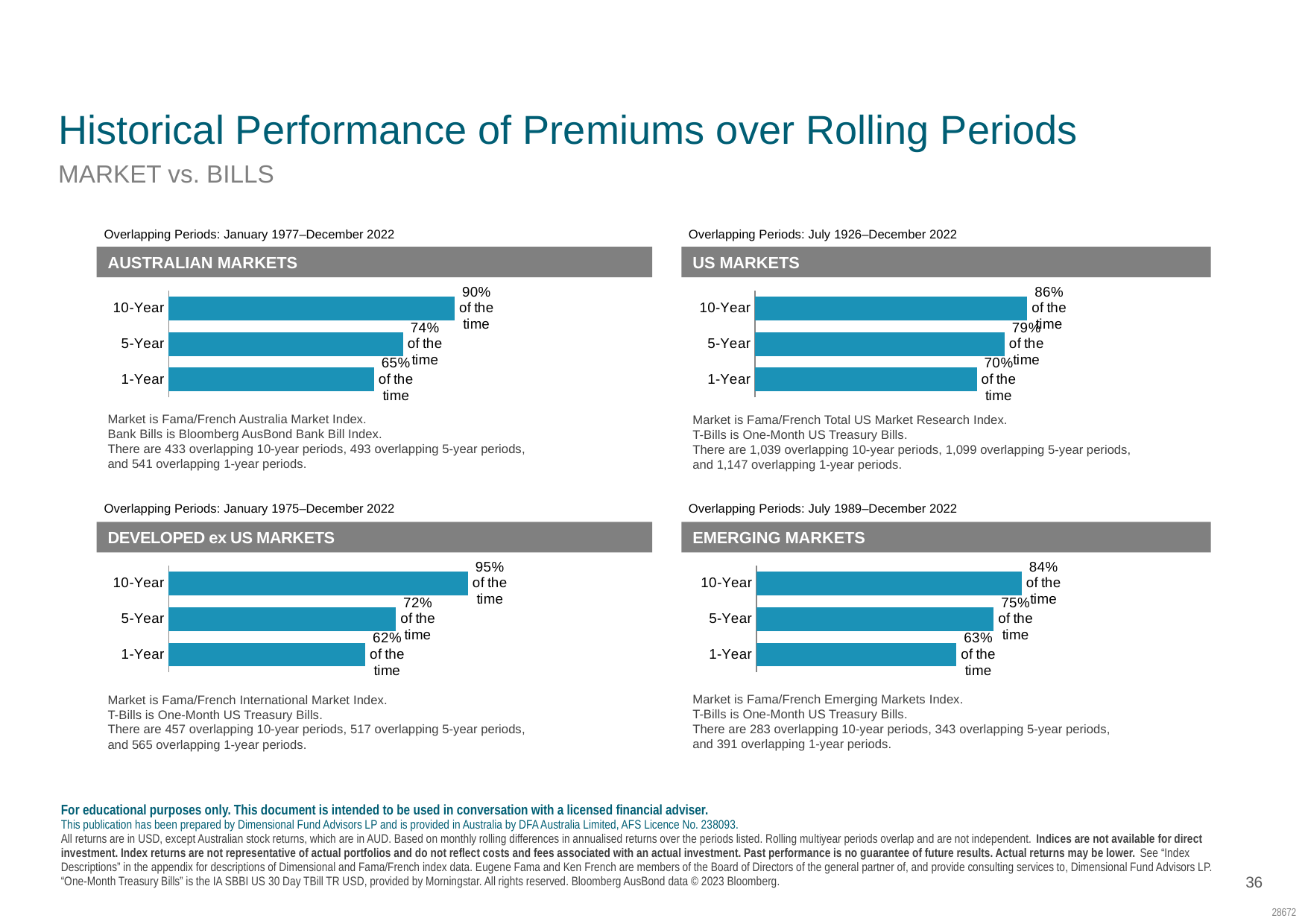
In the Australian Markets chart, what percentage of the time did the market beat bills over 10-year periods? 90% In the Developed ex US Markets chart, what is the value for 1-Year? 62% In the US Markets chart, what is the value for 5-Year? 79% In the Developed ex US Markets chart, which period has the highest value? 10-Year In the Emerging Markets chart, what is the value for 10-Year? 84% How many periods are shown in the Emerging Markets chart? 3 What type of chart is used in the US Markets chart? Bar chart In the Developed ex US Markets chart, do the values rise or fall as the period length increases from 1-Year to 10-Year? Rise In the Australian Markets chart, which period has the lowest value? 1-Year Which is larger: the 5-Year value in the Australian Markets chart or the 5-Year value in the US Markets chart? US Markets In the US Markets chart, what is the difference between the 10-Year and 1-Year values? 16% In the Emerging Markets chart, what is the difference between the 5-Year and 1-Year values? 12%